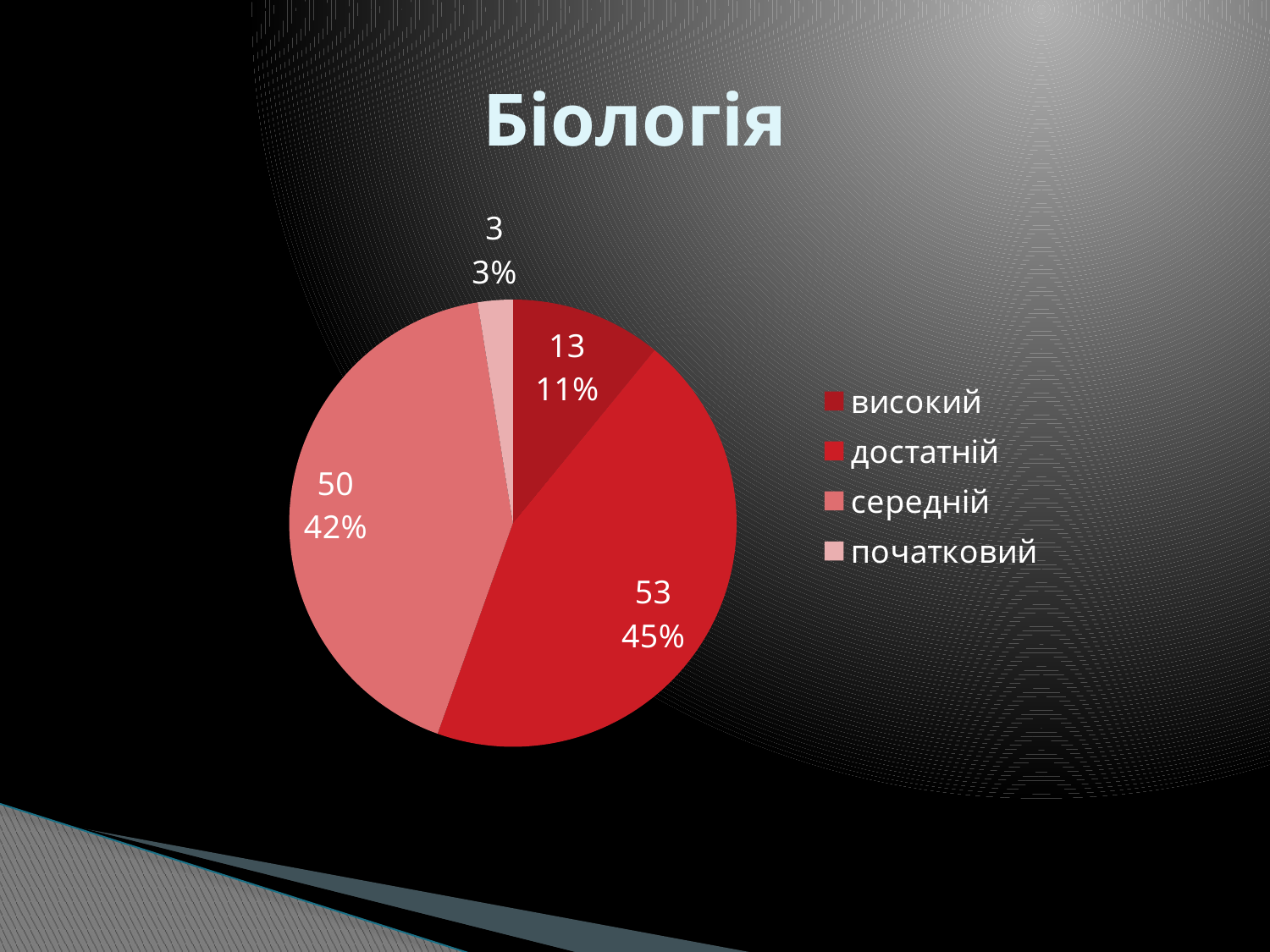
What share of the pie does достатній take? 45% What is the value for середній? 50 What share of the pie does високий take? 11% Which category has the smallest slice? початковий What is the difference between the values for достатній and середній? 3 Which category has the largest slice? достатній What is the value for початковий? 3 How many categories does the legend list? 4 What is the title of the chart? Біологія What is the value for високий? 13 What kind of chart is shown on the slide? pie chart What is the value for достатній? 53